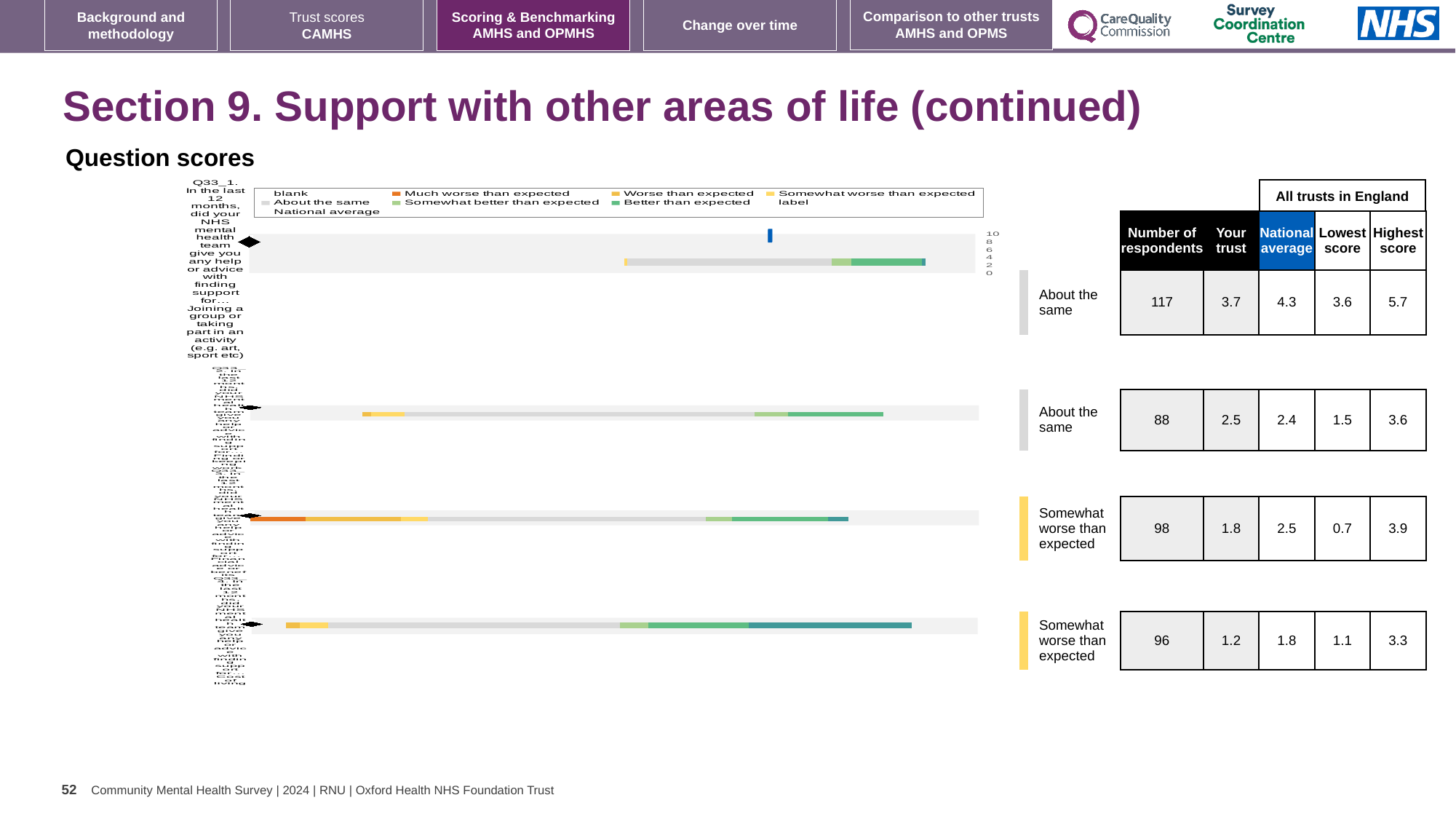
For the first question (Q33_1), what is the difference between the National average (4.3) and the Your trust score (3.7)? 0.6 Which row in the table has the highest number of respondents? the first row (Q33_1), 117 How many of the four rows are rated 'Somewhat worse than expected'? 2 In the table beside the chart, what is the 'Your trust' score for the first question (Q33_1, joining a group or taking part in an activity)? 3.7 In the table beside the chart, how many respondents are recorded for the first question (Q33_1)? 117 How many question bars are plotted in the chart? 4 In the table, what is the 'Highest score' for the last (fourth) row? 3.3 For the first question (Q33_1), which is larger: the 'Your trust' score or the 'National average'? National average Which row has the lowest 'Your trust' score in the table? the fourth row, 1.2 In the chart legend, which colour represents 'Much worse than expected'? orange What type of chart is shown under 'Question scores'? bar chart